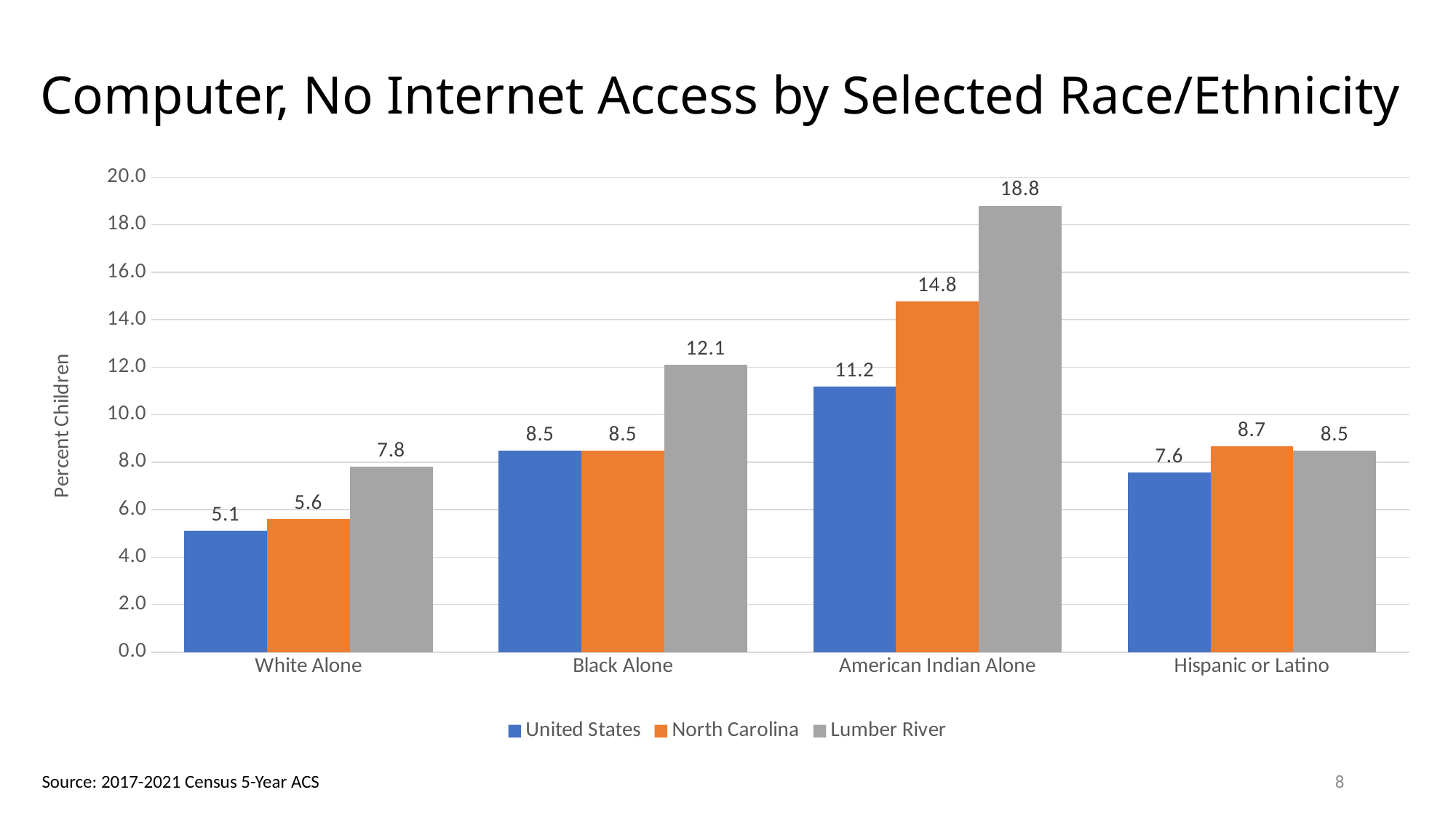
What is the label of the vertical axis? Percent Children What kind of chart is shown on the slide? Bar chart Which race/ethnicity category has the highest Lumber River value? American Indian Alone What is the North Carolina value for Hispanic or Latino? 8.7 How many series does the legend list? 3 What is the United States value for White Alone? 5.1 Is the North Carolina value for American Indian Alone greater or less than 14.0? greater What is the Lumber River value for American Indian Alone? 18.8 Which race/ethnicity category has the lowest United States value? White Alone Which is larger for Black Alone: the Lumber River value or the North Carolina value? Lumber River What is the difference between the Lumber River and United States values for American Indian Alone? 7.6 How many race/ethnicity categories are shown on the x axis? 4